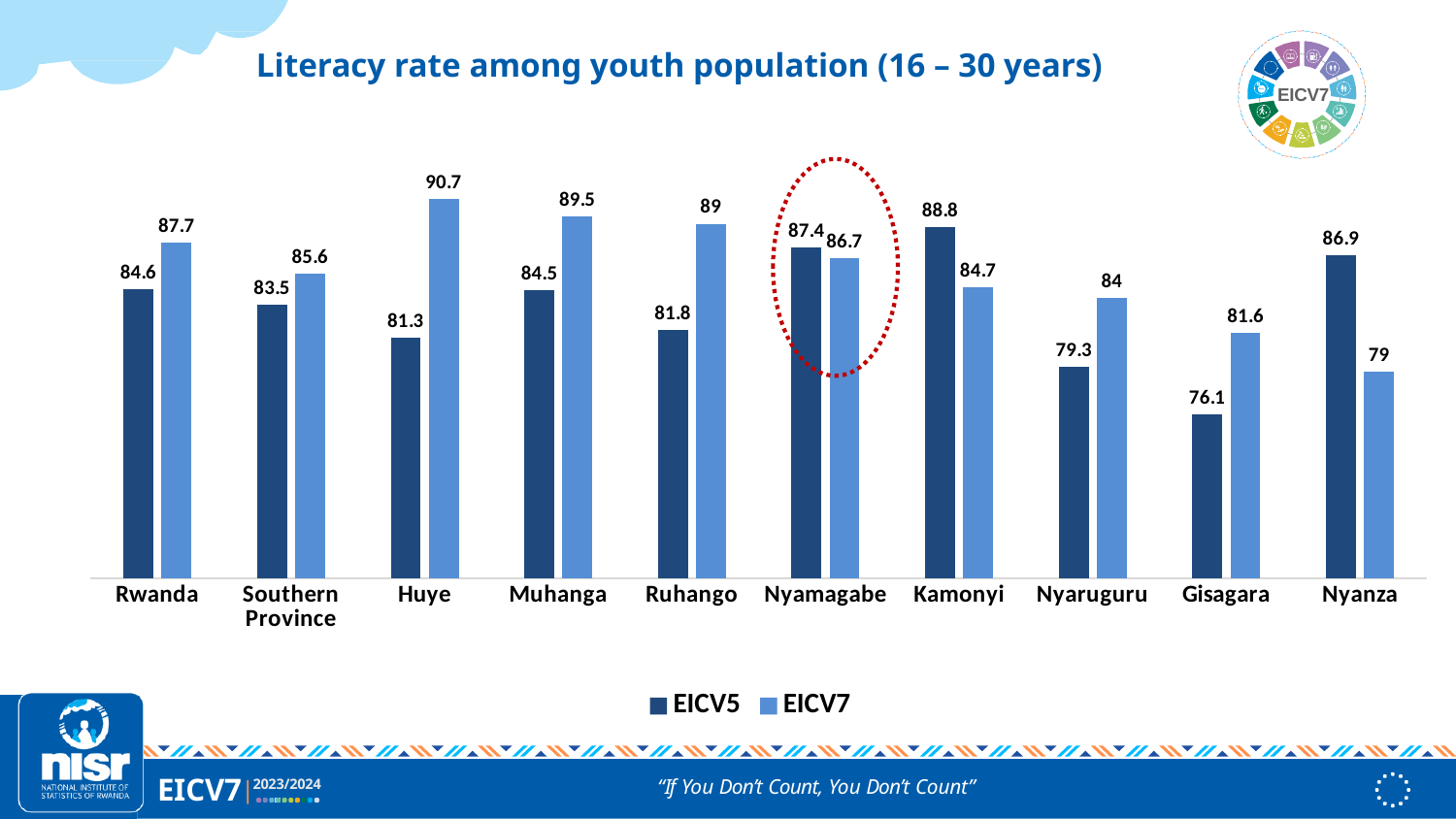
What is the difference between the EICV7 and EICV5 values for Huye? 9.4 What is the EICV7 value for Nyamagabe? 86.7 Which category has the lowest EICV7 value? Nyanza For Kamonyi, which is larger: the EICV5 value or the EICV7 value? EICV5 Which category has the highest EICV7 value? Huye What kind of chart is shown on the slide? Bar chart Which category has the lowest EICV5 value? Gisagara What is the difference between the EICV5 and EICV7 values for Nyanza? 7.9 What is the EICV5 literacy rate for Gisagara? 76.1 What is the EICV7 literacy rate for Huye? 90.7 How many series does the legend list? 2 How many categories are shown on the x axis? 10